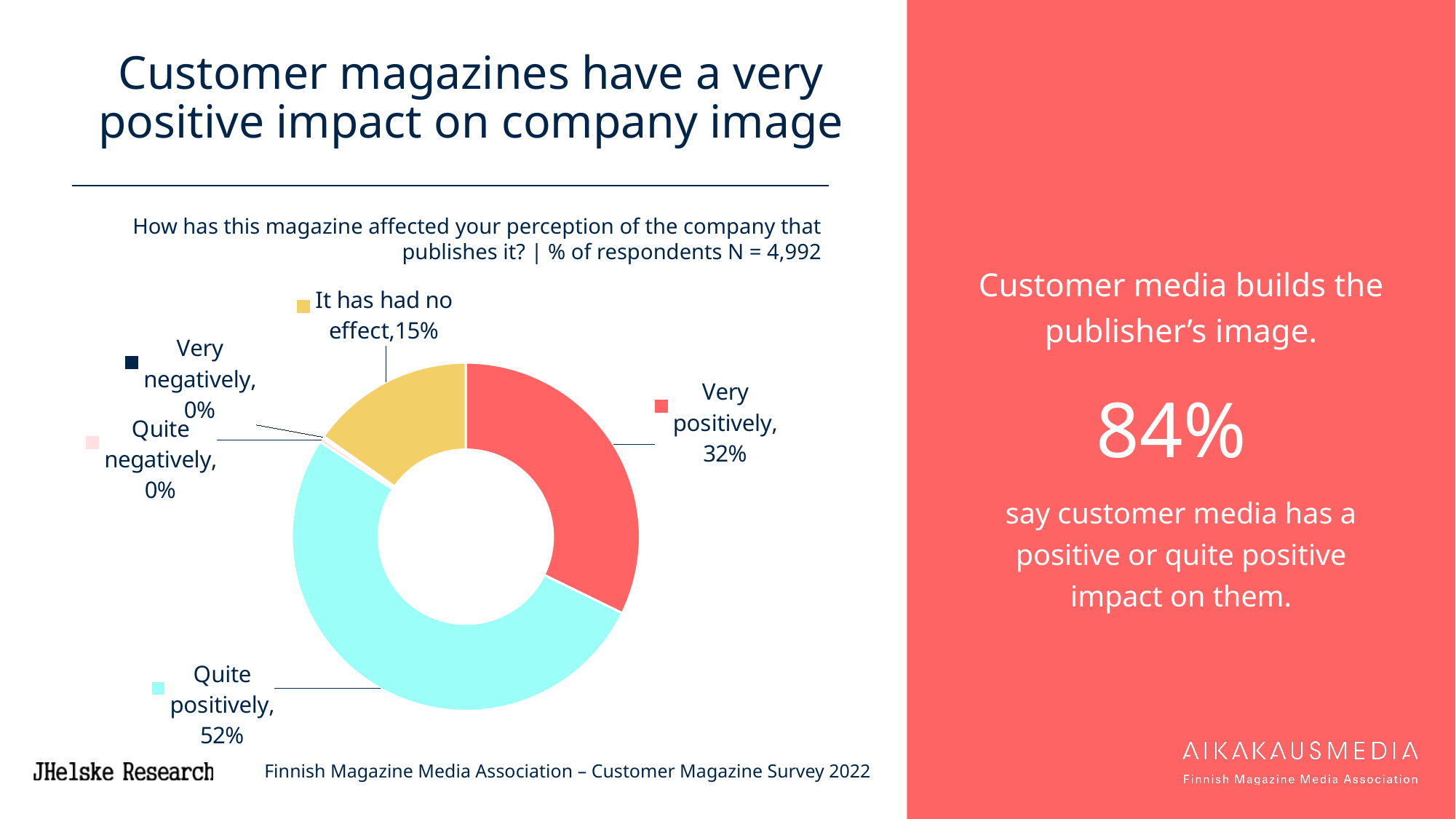
What percentage of respondents said the magazine affected their perception of the company 'Quite positively'? 52% Which response category has the largest share of respondents? Quite positively What share of respondents said the magazine 'has had no effect'? 15% What is the number of respondents (N) stated for the survey question? 4,992 How many response categories are shown in the chart? 5 What percentage of respondents answered 'Very negatively'? 0% What percentage of respondents said the magazine affected their perception 'Very positively'? 32% What type of chart is used on this slide? Pie chart (doughnut) What is the difference in percentage points between 'Quite positively' and 'Very positively'? 20 What colour represents the 'Quite positively' category in the chart? Light blue (cyan) Which is larger: the share for 'Very positively' or the share for 'It has had no effect'? Very positively What is the combined share of respondents who answered 'Very positively' or 'Quite positively'? 84%